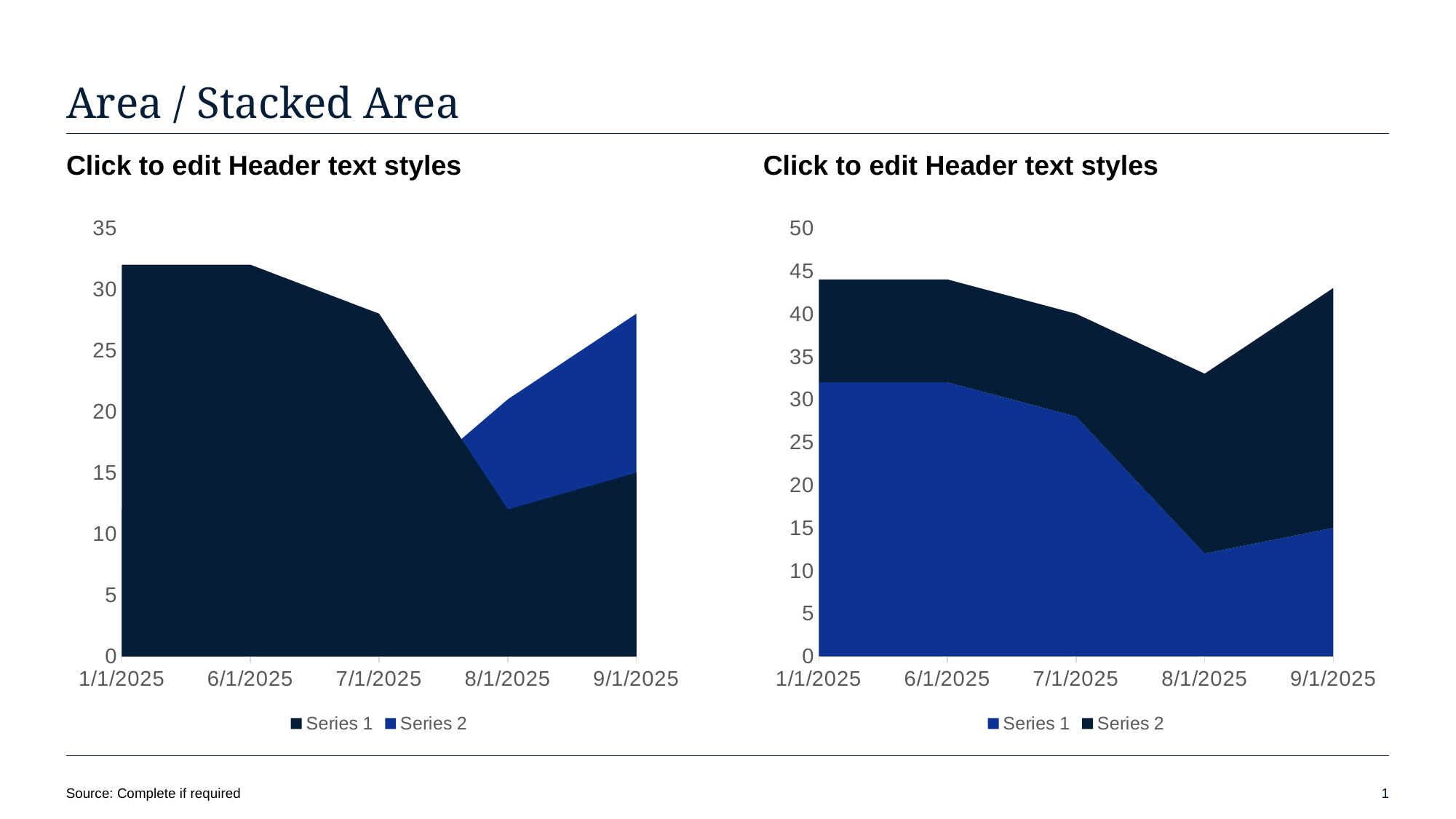
In the right chart, is the stacked total at 9/1/2025 greater or less than 40? greater In the left chart, does Series 1 rise or fall from 1/1/2025 to 8/1/2025? Fall In the right chart, which date has the lowest stacked total? 8/1/2025 In the left chart, is the value for Series 1 at 1/1/2025 greater or less than 30? greater In the left chart, is the value for Series 1 at 8/1/2025 greater or less than 15? less What is the title of the slide? Area / Stacked Area What kind of chart is the chart on the left of the slide? Area chart In the left chart, which series has the larger value at 9/1/2025, Series 1 or Series 2? Series 2 In the left chart, how many series does the legend list? 2 In the right chart, how many dates are shown on the x axis? 5 What kind of chart is the chart on the right of the slide? Stacked area chart